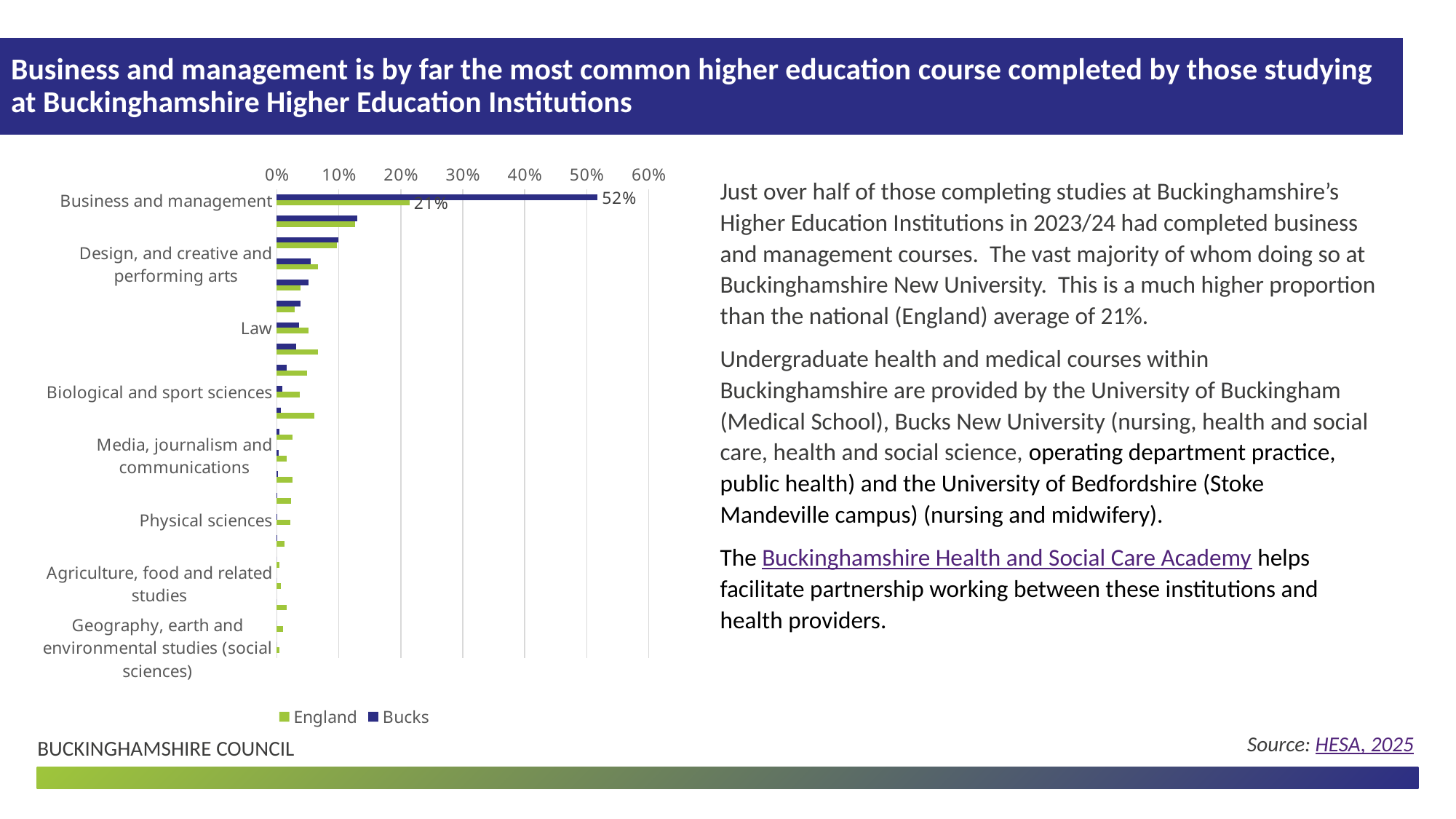
Is the England value for Physical sciences greater or less than 10%? less Is the Bucks value for Law greater or less than 10%? less Which category has the highest Bucks value? Business and management How many series does the legend list? 2 What are the two series named in the legend? England and Bucks What colour represents the England series? Green For Business and management, which is larger: the Bucks value or the England value? Bucks Is the Bucks value for Business and management greater or less than 50%? greater What is the difference between the Bucks and England values for Business and management? 31 percentage points What is the England value for Business and management? 21% What kind of chart is shown on the slide? Bar chart What is the Bucks value for Business and management? 52%